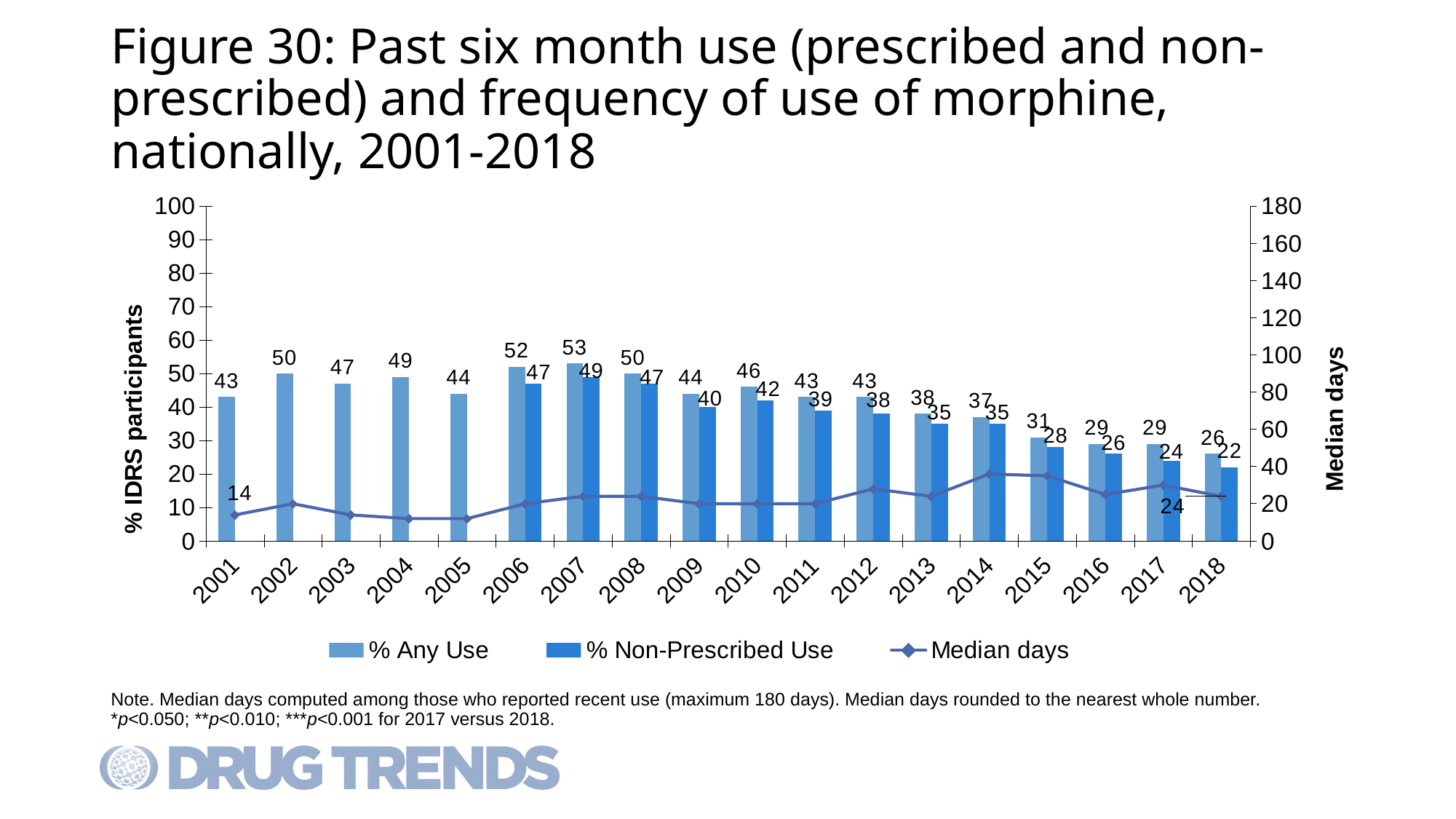
Which year has the lowest % Non-Prescribed Use? 2018 Is the Median days value for 2014 greater or less than 20? greater Does % Any Use rise or fall from 2012 to 2018? fall What is the % Non-Prescribed Use value for 2018? 22 Which year has the larger % Any Use, 2002 or 2005? 2002 What is the difference between % Any Use and % Non-Prescribed Use in 2007? 4 What is the Median days value for 2001? 14 How many years are shown on the x axis? 18 What is the % Any Use value for 2007? 53 Which year has the highest % Any Use? 2007 How many series does the legend list? 3